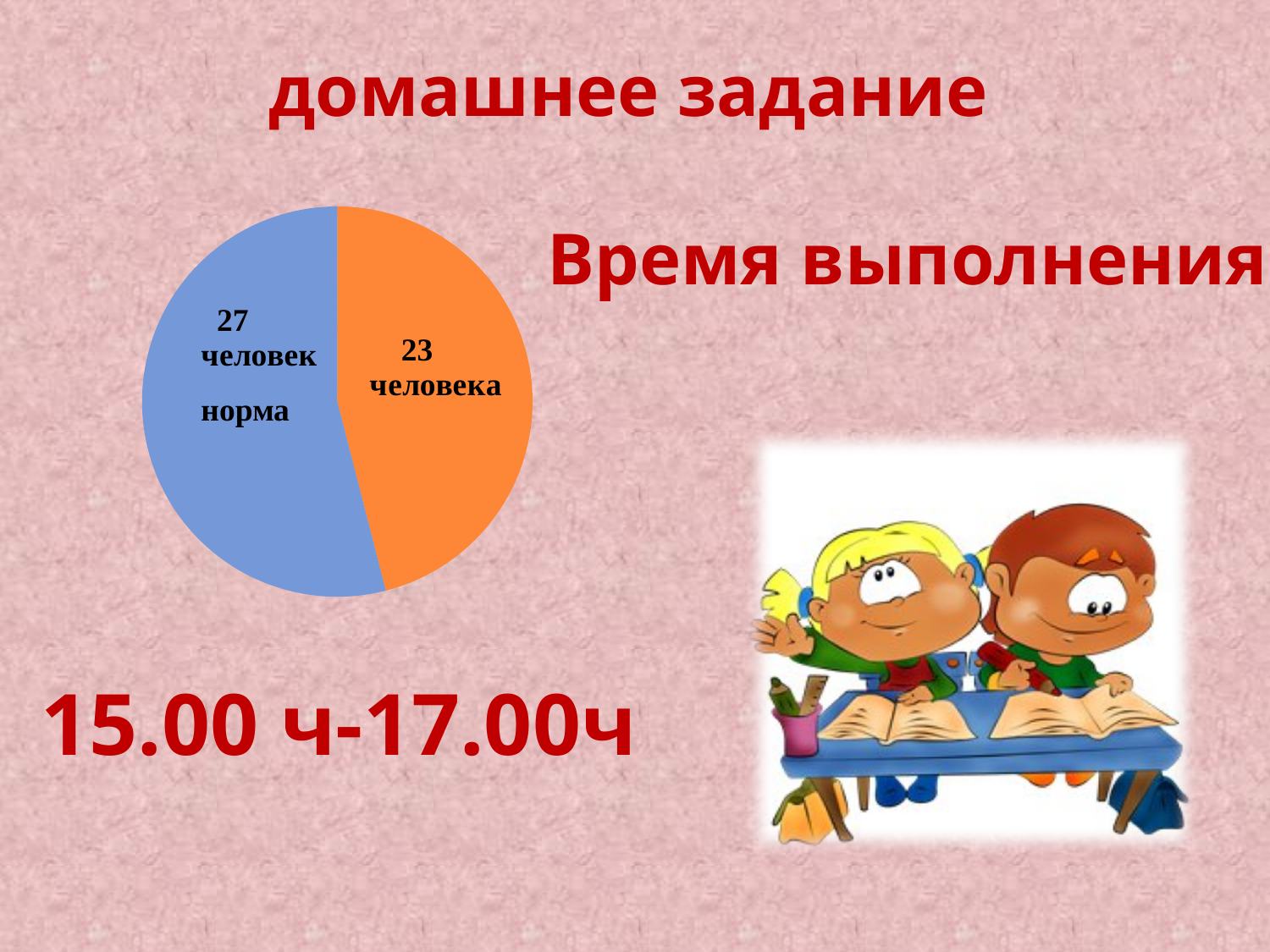
What value is printed on the blue slice of the pie chart? 27 человек What share of the pie does the blue slice (27 человек) represent? 54% What kind of chart is shown on the slide? pie chart How many slices does the pie chart have? 2 Which slice of the pie chart is labelled 'норма'? the blue slice Which slice of the pie chart represents the smallest number of people? the orange slice (23 человека) Which slice of the pie chart is larger, the blue one or the orange one? the blue one Which slice of the pie chart represents the largest number of people? the blue slice (27 человек, норма) What is the difference between the number of people in the blue slice and the orange slice? 4 What value is printed on the orange slice of the pie chart? 23 человека What is the total number of people represented in the pie chart? 50 What share of the pie does the orange slice (23 человека) represent? 46%